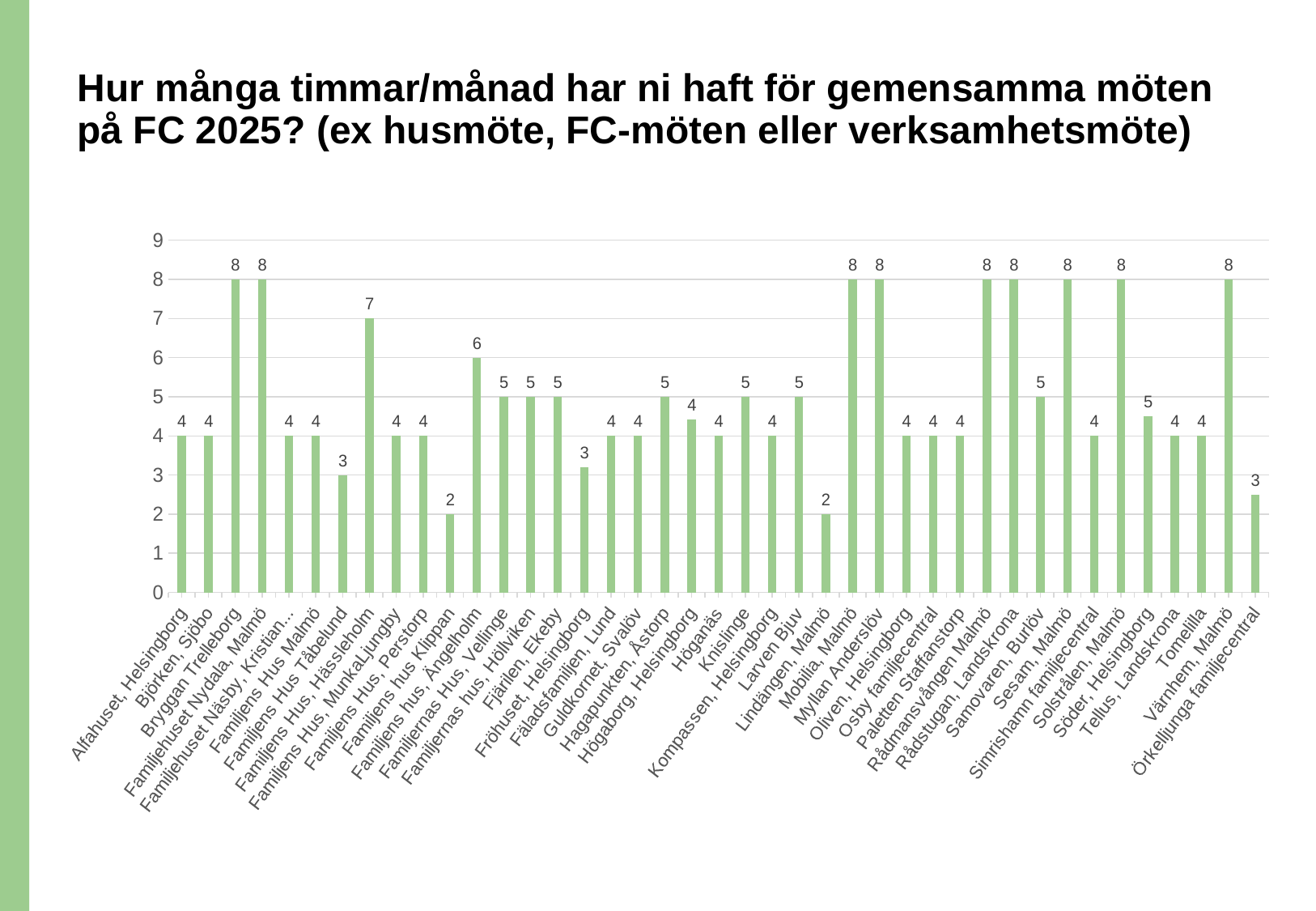
What kind of chart is shown on the slide? Bar chart How many categories are shown on the x axis? 41 What value is shown for Örkelljunga familjecentral? 3 What is the difference between the values for Bryggan Trelleborg and Familjens Hus Tåbelund? 5 What is the title of the slide? Hur många timmar/månad har ni haft för gemensamma möten på FC 2025? (ex husmöte, FC-möten eller verksamhetsmöte) Which has a larger value, Knislinge or Höganäs? Knislinge What value is shown for Samovaren, Burlöv? 5 What value is shown for Familjens hus, Ängelholm? 6 What is the highest value shown on the chart? 8 What value is shown for Familjens Hus, Hässleholm? 7 What is the lowest value shown on the chart? 2 What value is shown for Lindängen, Malmö? 2